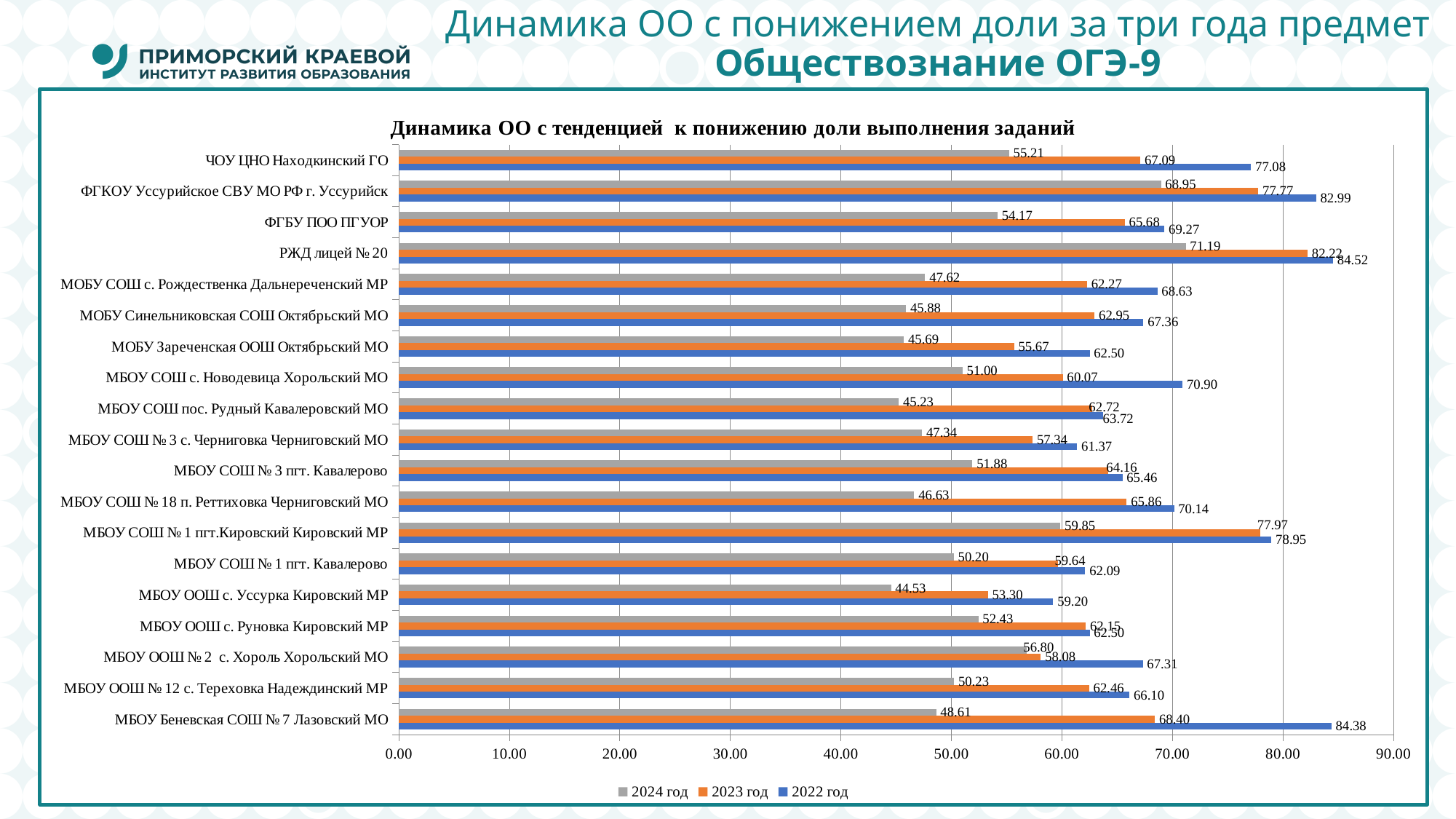
What is the 2023 год value for МОБУ Зареченская ООШ Октябрьский МО? 55.67 Which organisation has the highest 2024 год value? РЖД лицей № 20 Which organisation has the lowest 2024 год value? МБОУ ООШ с. Уссурка Кировский МР Which is larger for МБОУ СОШ № 1 пгт.Кировский Кировский МР: the 2023 год value or the 2024 год value? 2023 год What is the difference between the 2022 год and 2024 год values for ЧОУ ЦНО Находкинский ГО? 21.87 What type of chart is shown on the slide? Bar chart How many organisations are listed on the chart? 19 Which organisation has the highest 2023 год value? РЖД лицей № 20 What is the 2024 год value for РЖД лицей № 20? 71.19 What is the 2022 год value for МБОУ Беневская СОШ № 7 Лазовский МО? 84.38 Is the 2022 год value for ФГКОУ Уссурийское СВУ МО РФ г. Уссурийск greater or less than 80.00? greater How many series does the legend list? 3